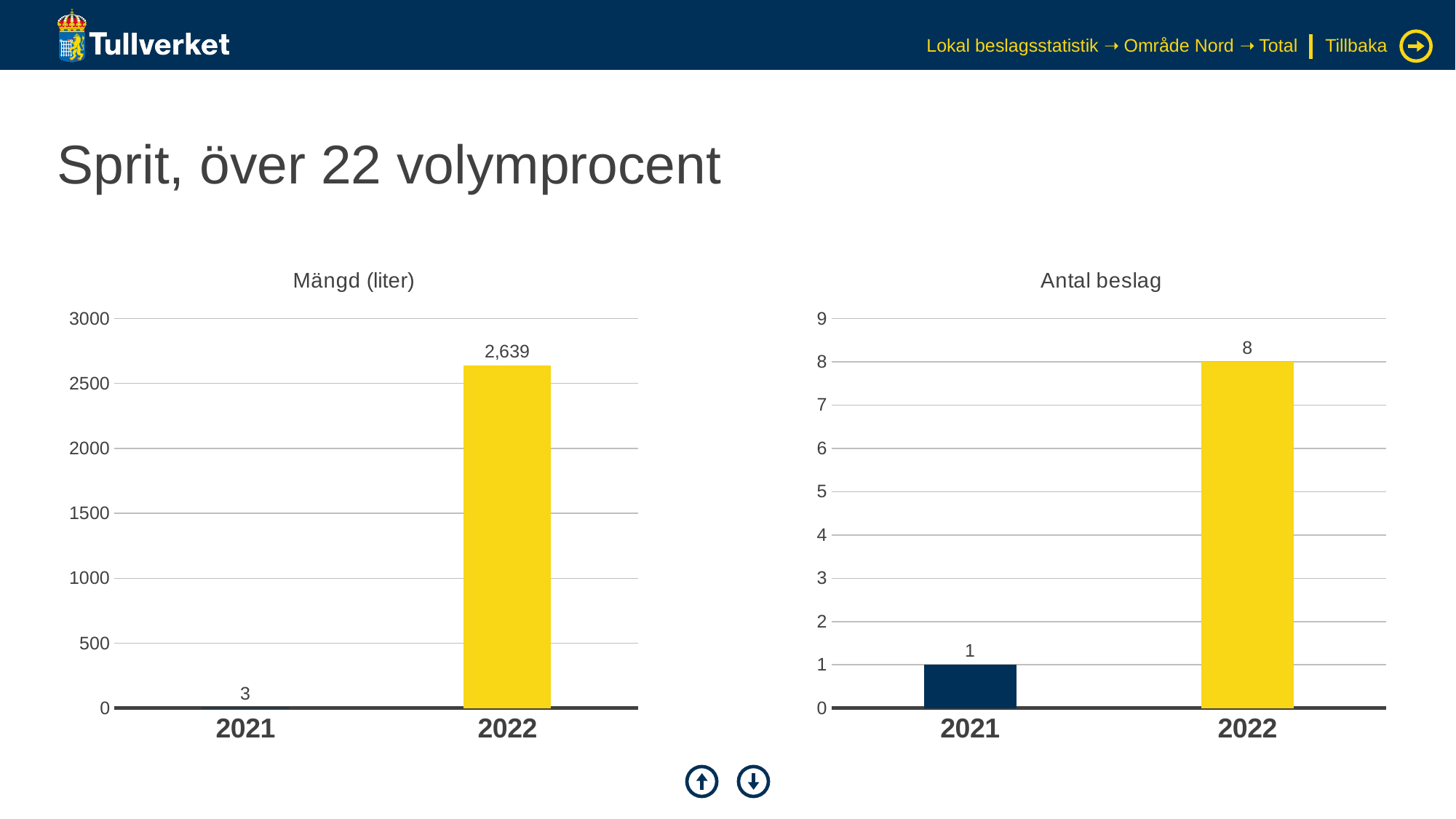
In the 'Mängd (liter)' chart, what is the value for 2021? 3 In the 'Mängd (liter)' chart, what is the value for 2022? 2,639 In the 'Mängd (liter)' chart, is the value for 2022 greater or less than 2500? greater How many categories are shown on the x axis of the 'Antal beslag' chart? 2 In the 'Antal beslag' chart, do the values rise or fall from 2021 to 2022? rise In the 'Antal beslag' chart, which year has the lowest value? 2021 In the 'Antal beslag' chart, what is the value for 2021? 1 In the 'Antal beslag' chart, what is the difference between the 2022 and 2021 values? 7 In the 'Antal beslag' chart, what is the value for 2022? 8 In the 'Mängd (liter)' chart, what is the difference between the 2022 and 2021 values? 2,636 In the 'Mängd (liter)' chart, which year has the highest value? 2022 What kind of chart is the 'Mängd (liter)' chart? bar chart